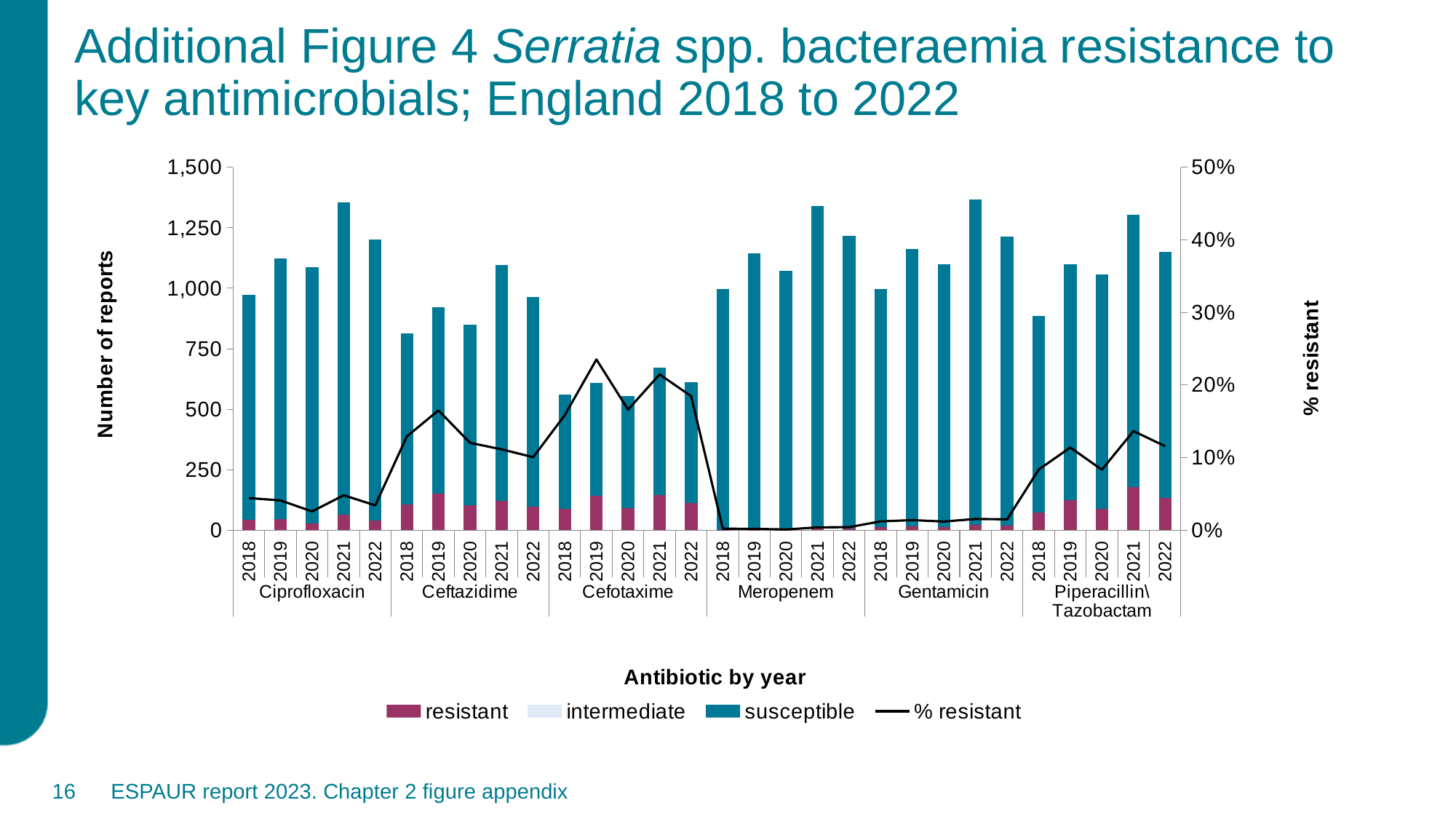
Which antibiotic has the highest % resistant value on the line? Cefotaxime Is the total number of reports for Piperacillin\Tazobactam in 2018 greater or less than 1,000? less How many series does the legend list? 4 Which antibiotic has the lowest % resistant values across all years? Meropenem Which has more total reports: Cefotaxime in 2018 or Meropenem in 2018? Meropenem in 2018 Is the total number of reports for Cefotaxime in 2018 greater or less than 750? less What is the title of the left vertical axis? Number of reports How many bars are plotted in total across all antibiotics? 30 Is the % resistant for Cefotaxime in 2019 greater or less than 20%? greater What kind of chart is shown on the slide? Stacked bar chart with a line How many antibiotics are shown along the x axis? 6